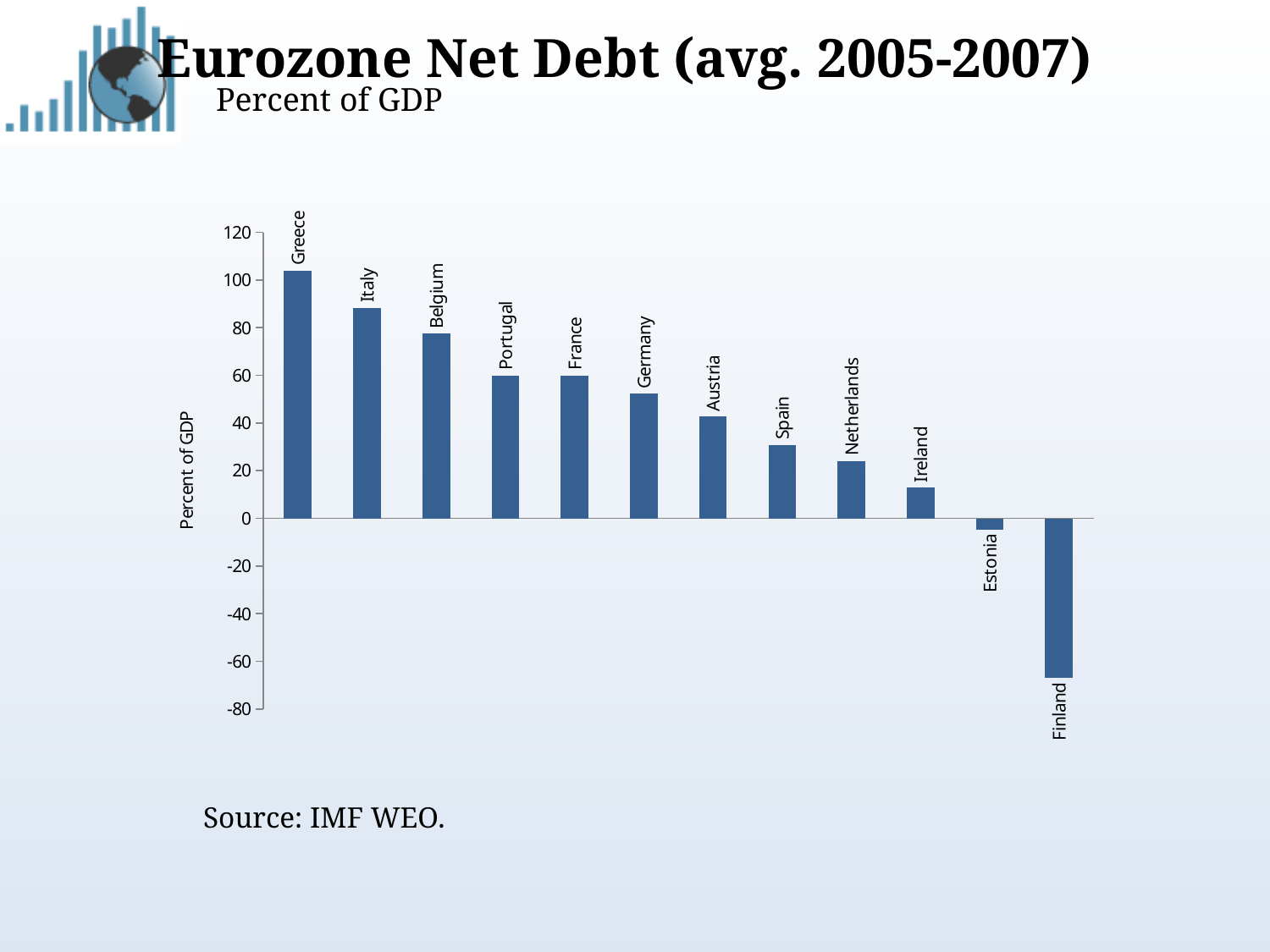
How many countries are shown in the chart? 12 Which is larger, the value for Spain or the value for Netherlands? Spain Which country has the lowest net debt as a percent of GDP? Finland Which is larger, the value for Belgium or the value for Austria? Belgium Is the value for Greece greater or less than 100? greater Is the value for Germany greater or less than 60? less What is the label on the vertical axis of the chart? Percent of GDP What kind of chart is shown on the slide? bar chart Which country has the highest net debt as a percent of GDP? Greece Is the value for Finland greater or less than -60? less Do the values generally rise or fall moving from left to right across the chart? fall